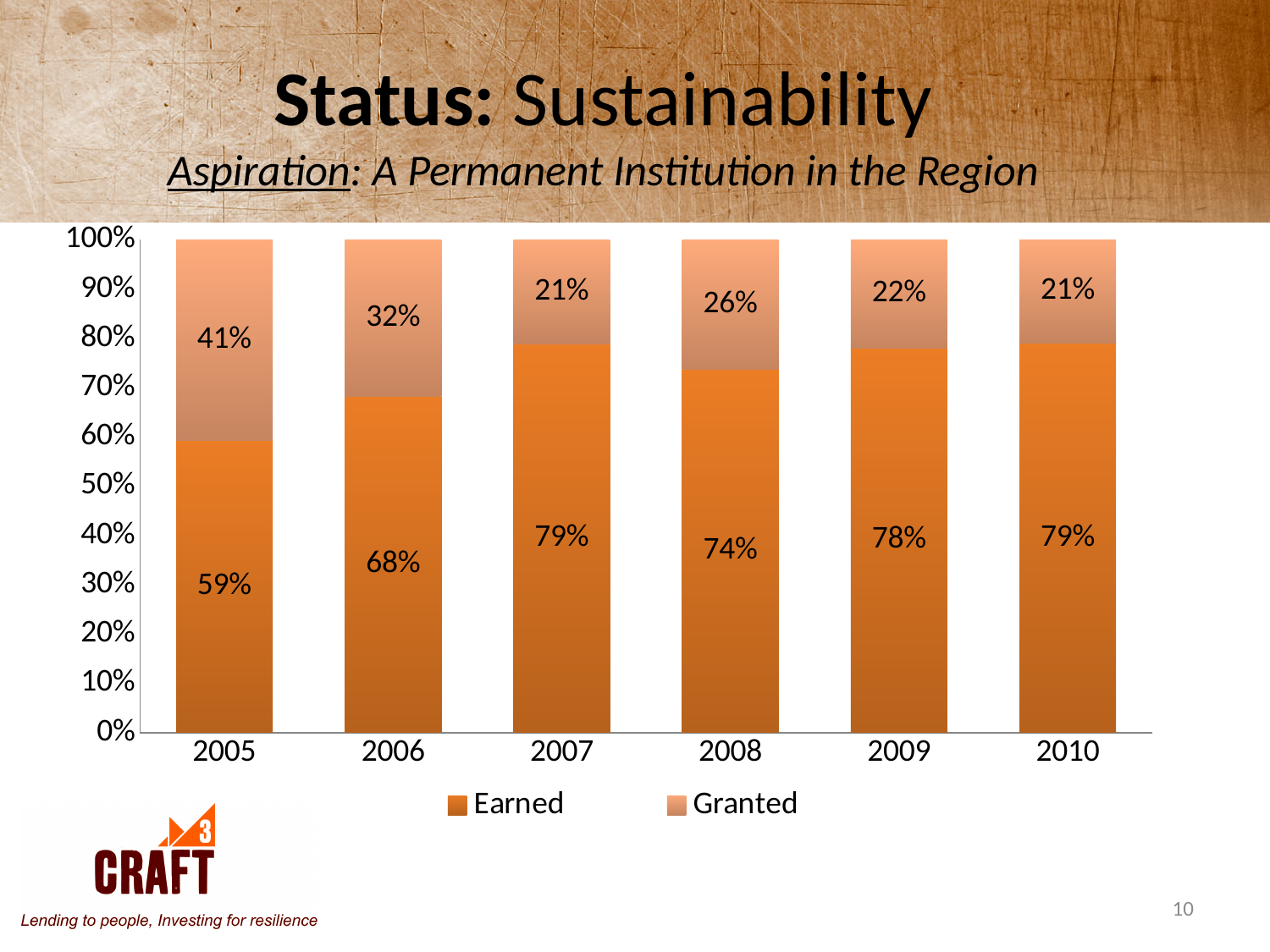
What is the Earned value for 2009? 78% What is the Earned value for 2005? 59% Which is larger, the Granted value for 2008 or the Granted value for 2009? 2008 What kind of chart is shown on the slide? Stacked bar chart How many years are shown on the x axis? 6 What is the Granted value for 2008? 26% What are the two series named in the legend? Earned and Granted How many series does the legend list? 2 Which year has the highest Granted value? 2005 Which year has the lowest Earned value? 2005 What is the Granted value for 2006? 32% What is the difference between the Earned values for 2006 and 2005? 9%